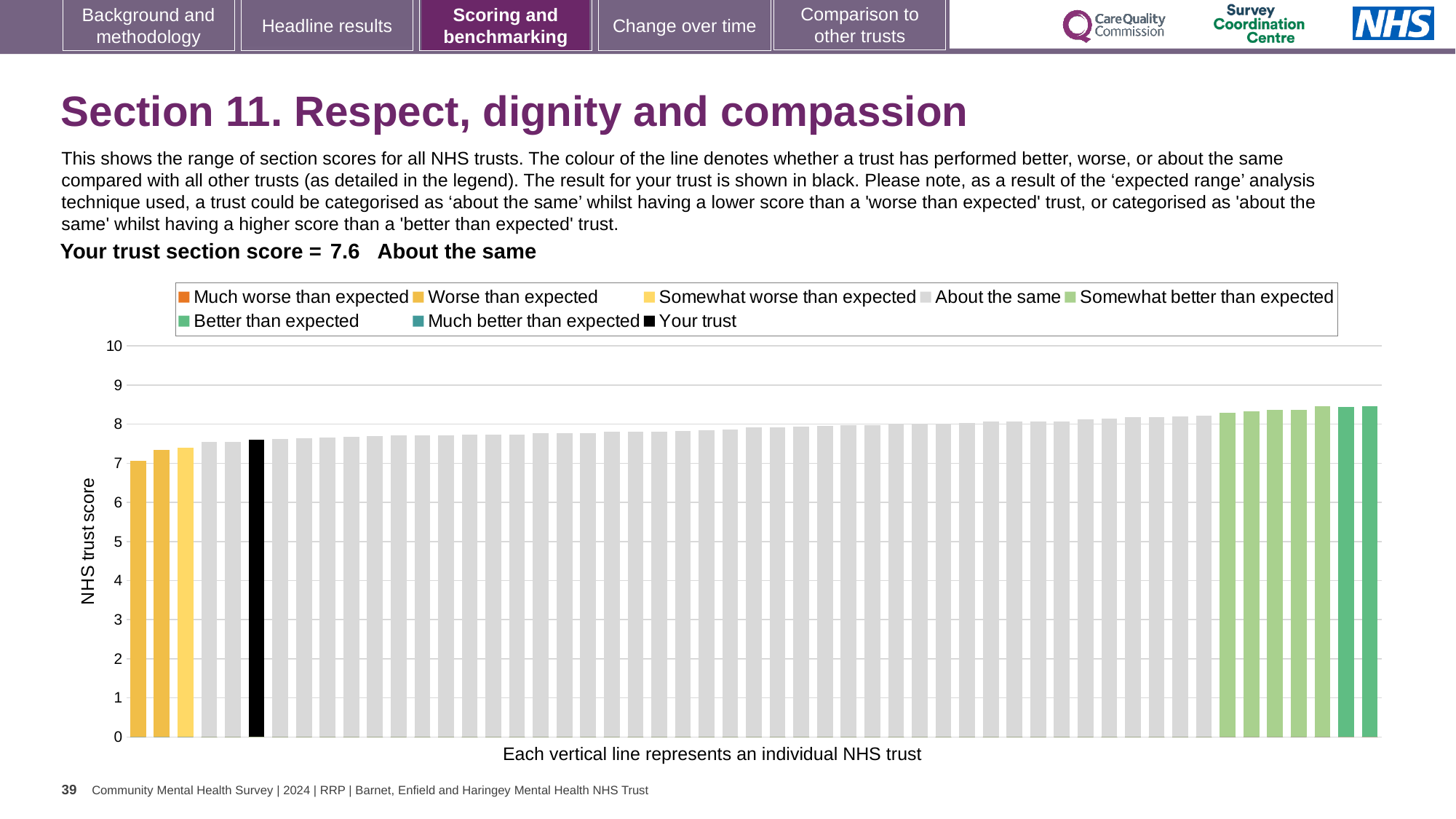
Is the value of the leftmost bar greater or less than 8? less What is the section score for your trust shown on the slide? 7.6 Is the leftmost bar taller or shorter than the rightmost bar? shorter How many entries does the chart legend list? 8 Is the black bar for your trust taller or shorter than the leftmost bar? taller What kind of chart is shown on the slide? bar chart Is the value for your trust greater or less than 7? greater Is the value of the rightmost bar greater or less than 8? greater Which legend entry is shown in black? Your trust What is the title of the vertical axis? NHS trust score Do the bar heights rise or fall from left to right along the x axis? rise